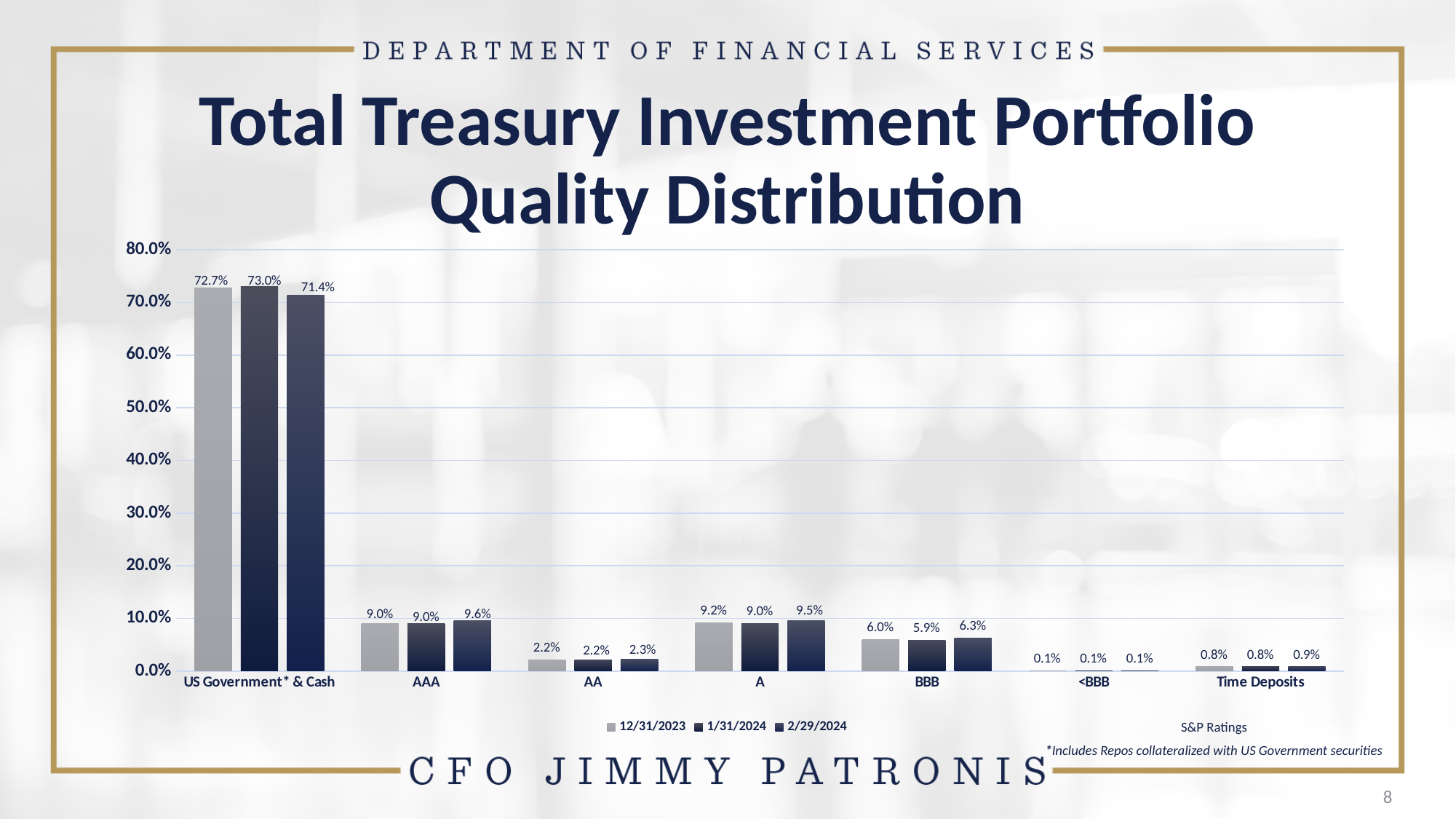
Which is larger for the 2/29/2024 series: the value for AAA or the value for A? AAA Which category has the lowest value for the 12/31/2023 series? <BBB What is the value for A for the 2/29/2024 series? 9.5% What is the difference between the 1/31/2024 and 2/29/2024 values for US Government* & Cash? 1.6% Is the value for US Government* & Cash in the 12/31/2023 series greater or less than 70.0%? greater What is the value for US Government* & Cash for the 2/29/2024 series? 71.4% How many series does the legend list? 3 How many categories are shown on the x axis? 7 Which category has the highest value for the 1/31/2024 series? US Government* & Cash What is the value for AAA for the 12/31/2023 series? 9.0% What kind of chart is shown on the slide? Bar chart What is the value for BBB for the 1/31/2024 series? 5.9%